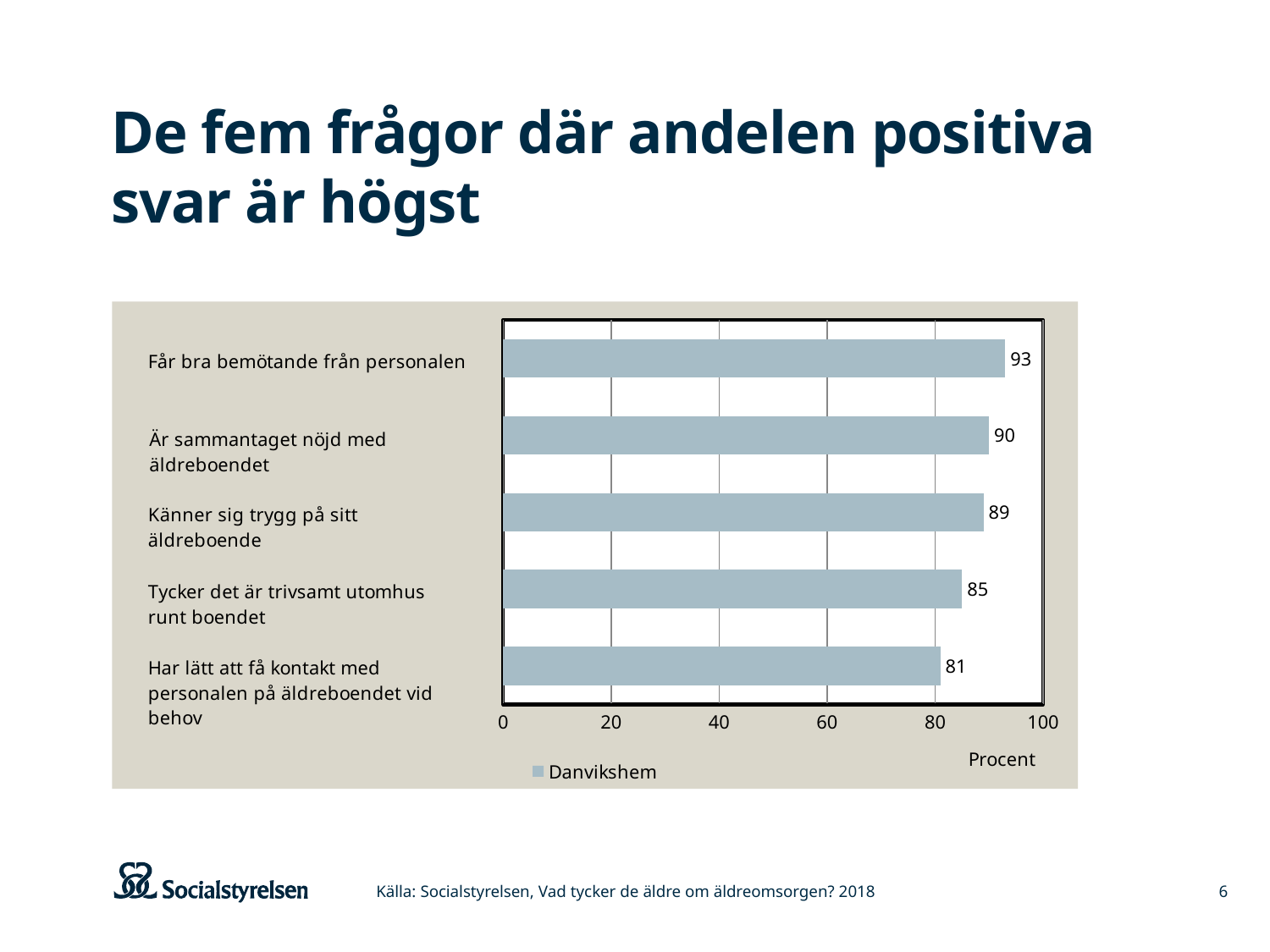
What series name is shown in the legend? Danvikshem What is the value for "Tycker det är trivsamt utomhus runt boendet"? 85 What is the value for "Har lätt att få kontakt med personalen på äldreboendet vid behov"? 81 Which category has the lowest value? Har lätt att få kontakt med personalen på äldreboendet vid behov Which is larger: the value for "Känner sig trygg på sitt äldreboende" or the value for "Tycker det är trivsamt utomhus runt boendet"? Känner sig trygg på sitt äldreboende What kind of chart is shown on the slide? bar chart Is the value for "Tycker det är trivsamt utomhus runt boendet" greater or less than 80? greater What is the difference between the values for "Är sammantaget nöjd med äldreboendet" and "Har lätt att få kontakt med personalen på äldreboendet vid behov"? 9 What is the value for "Får bra bemötande från personalen"? 93 How many series does the legend list? 1 Which category has the highest value? Får bra bemötande från personalen How many categories are shown in the chart? 5